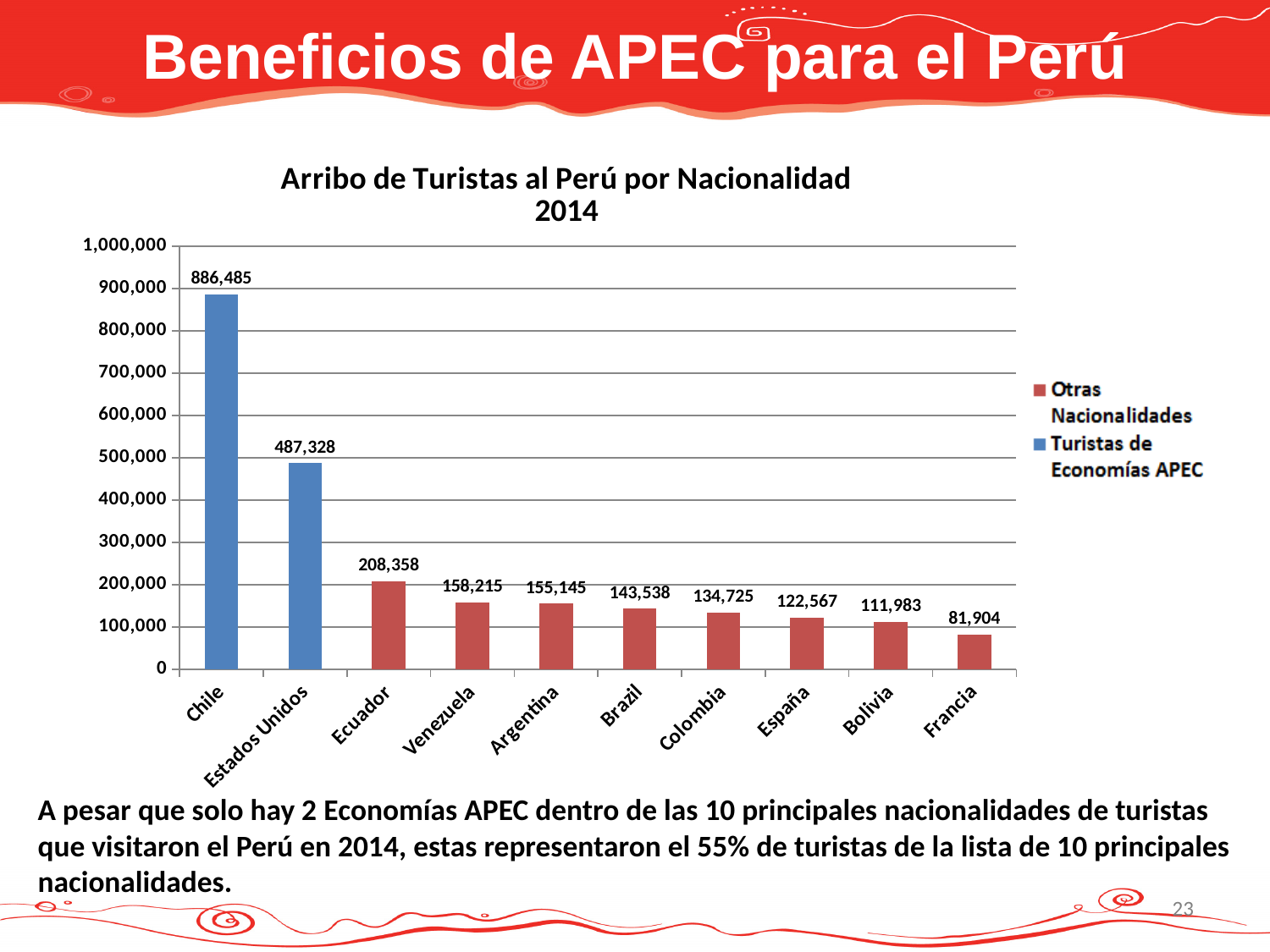
Which legend entry corresponds to the blue bars? Turistas de Economías APEC What is the number of tourist arrivals from Estados Unidos? 487,328 What is the number of tourist arrivals from Chile? 886,485 What is the value shown for Colombia? 134,725 Is the value for Bolivia greater or less than 100,000? greater Which has a larger value, Ecuador or Venezuela? Ecuador Which nationality has the lowest number of tourist arrivals? Francia Which nationality has the highest number of tourist arrivals? Chile What kind of chart is shown on the slide? Bar chart What is the difference between the values for Chile and Estados Unidos? 399,157 How many nationalities are shown on the x axis? 10 How many series does the legend list? 2